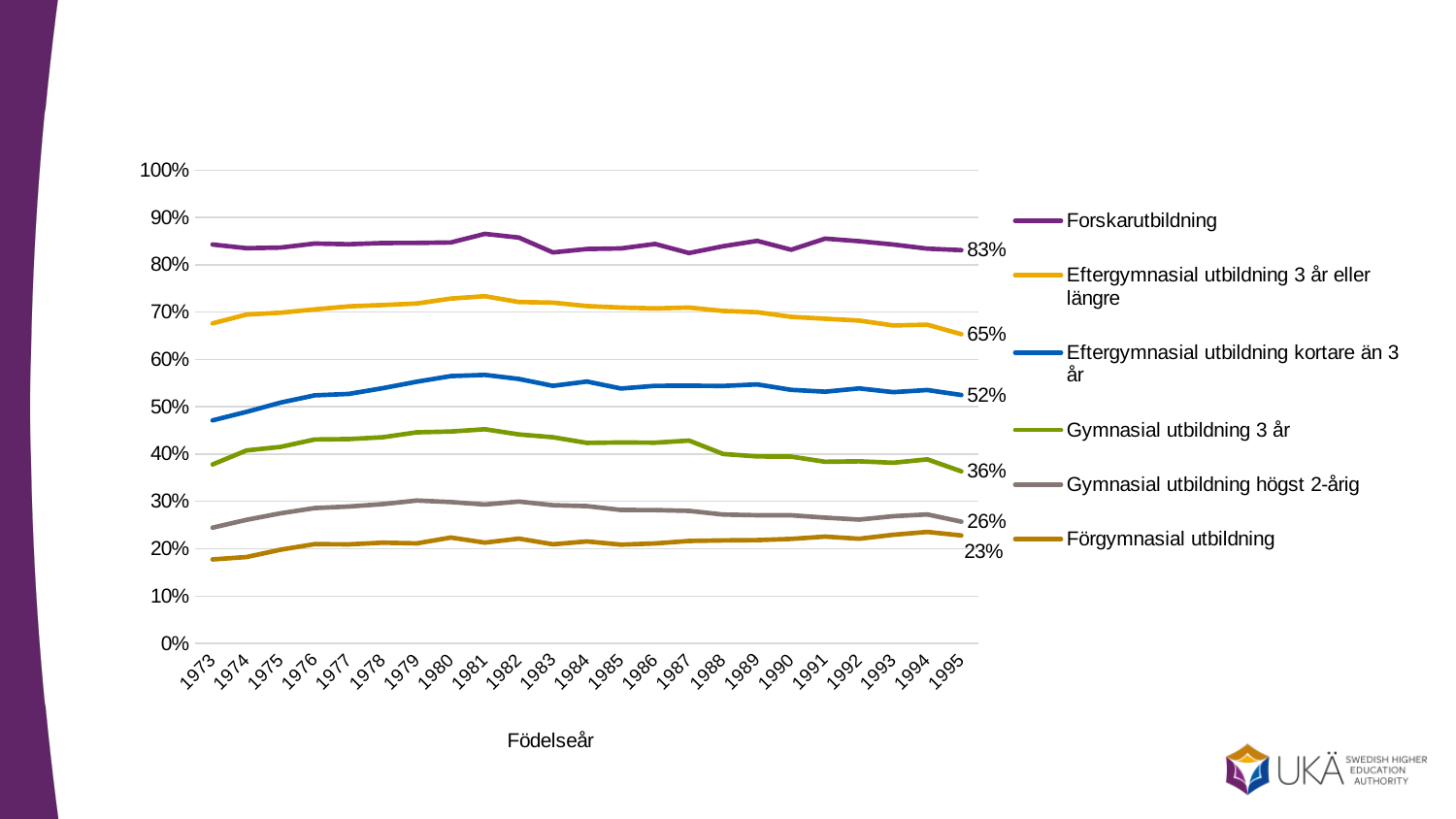
What is the title of the x axis? Födelseår At birth year 1995, which is larger: Gymnasial utbildning 3 år or Gymnasial utbildning högst 2-årig? Gymnasial utbildning 3 år What is the value for Förgymnasial utbildning at birth year 1995? 23% How many birth years are shown on the x axis? 23 What is the value for Eftergymnasial utbildning 3 år eller längre at birth year 1995? 65% How many series does the legend list? 6 Is the value for Eftergymnasial utbildning kortare än 3 år at birth year 1973 greater or less than 50%? less What is the value for Forskarutbildning at birth year 1995? 83% Which series has the lowest value at birth year 1995? Förgymnasial utbildning What is the difference between the 1995 values for Forskarutbildning and Eftergymnasial utbildning kortare än 3 år? 31 percentage points Which series has the highest value at birth year 1995? Forskarutbildning What type of chart is shown on the slide? Line chart